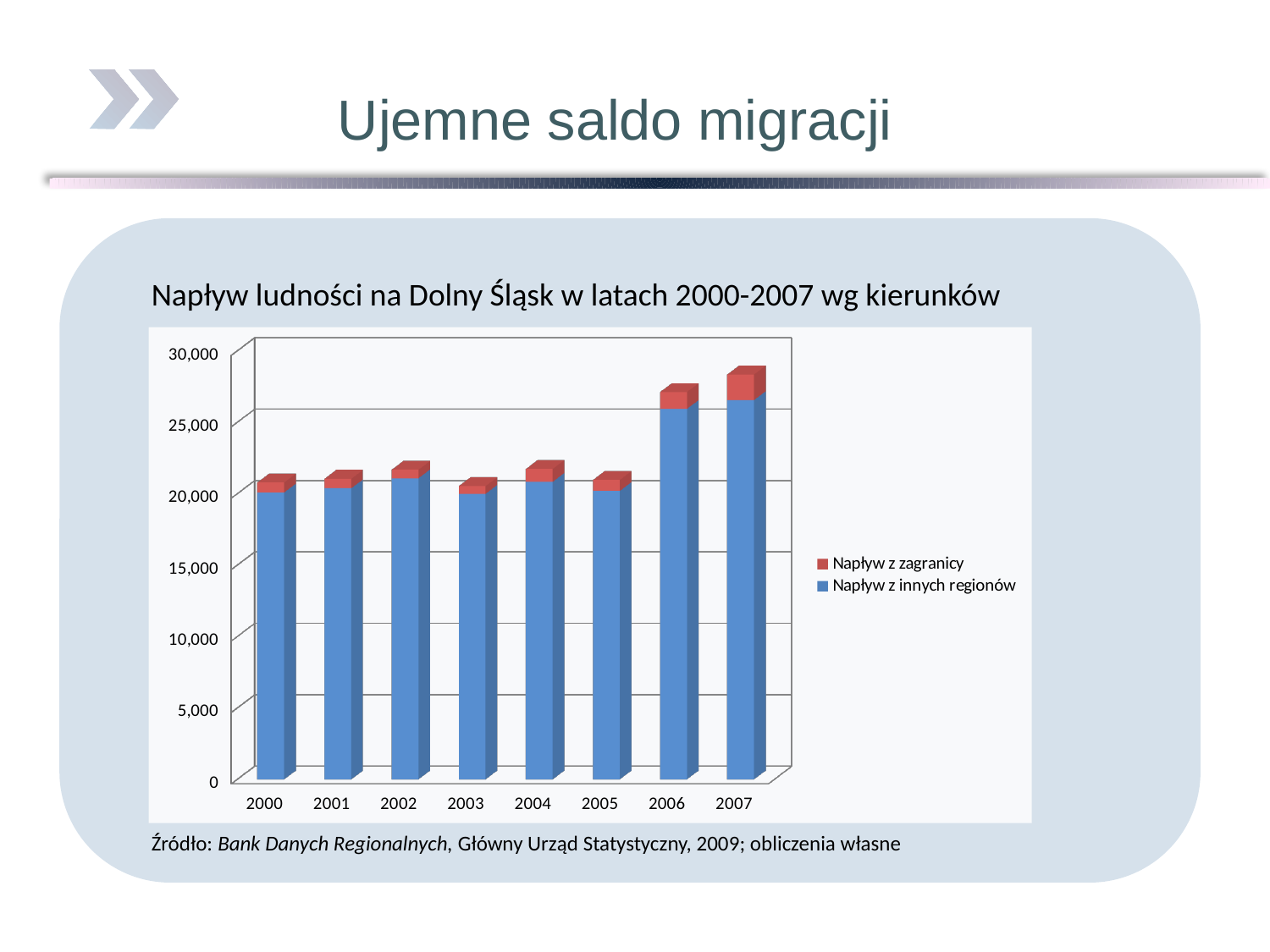
What kind of chart is shown on the slide? Stacked bar chart Is the total value for 2006 greater or less than 25,000? greater How many series does the chart's legend list? 2 Is the total value for 2007 greater or less than 30,000? less What is the title of the chart? Napływ ludności na Dolny Śląsk w latach 2000-2007 wg kierunków Do the total values rise or fall from 2005 to 2007? rise Which year has the highest total inflow of population in the chart? 2007 Which colour represents 'Napływ z zagranicy' in the chart? Red Is the value for 'Napływ z innych regionów' in 2005 greater or less than 15,000? greater How many years are shown on the x axis of the chart? 8 Which year has the larger total inflow, 2005 or 2006? 2006